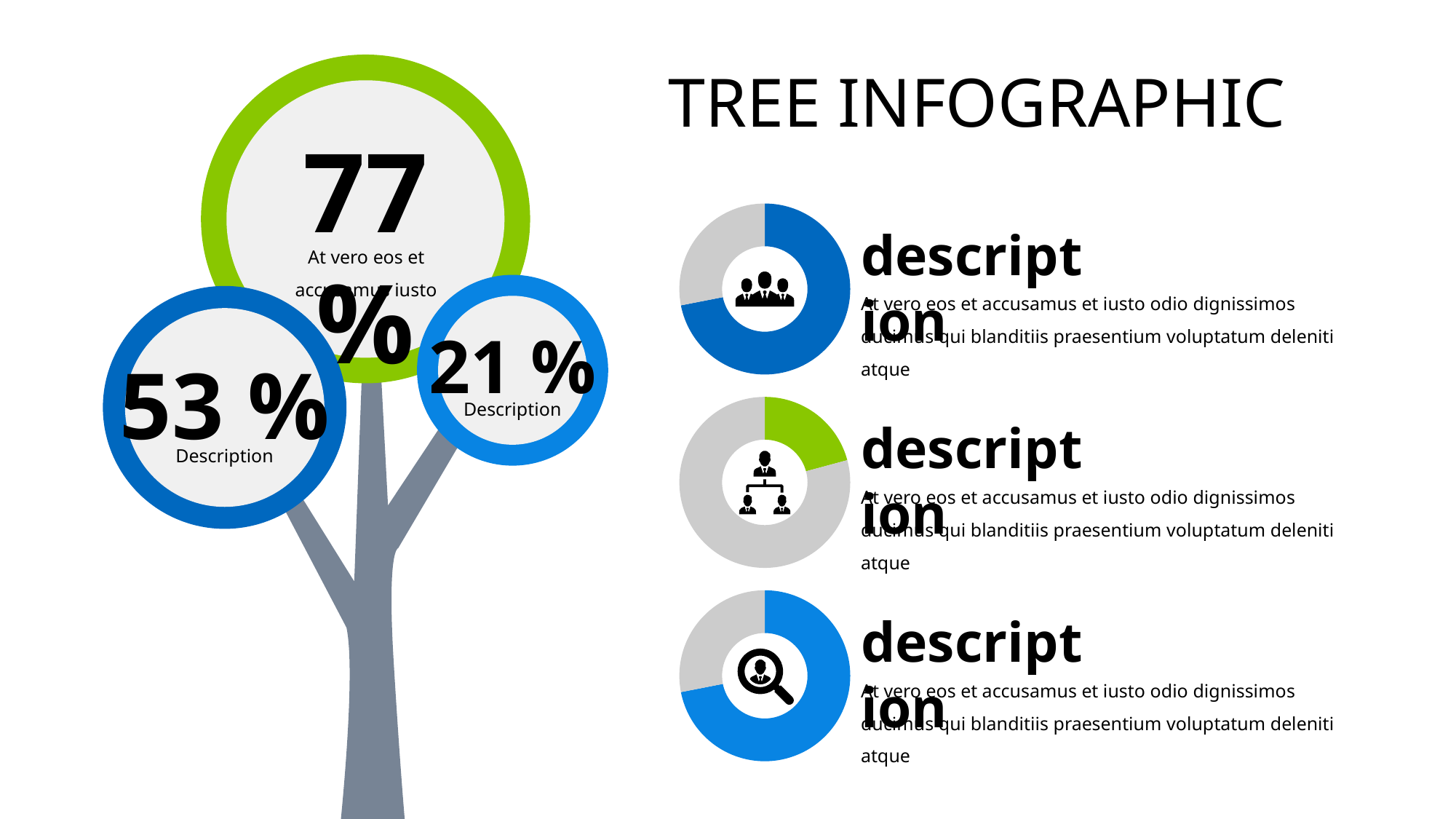
What colour is the filled segment of the top donut chart? Dark blue What kind of chart is shown three times on the right side of the slide? Donut (pie) chart What colour is the filled segment of the middle donut chart? Green How many donut charts are on the slide? 3 Is the coloured segment of the top donut chart larger or smaller than the coloured segment of the middle donut chart? Larger Which of the three donut charts has the smallest coloured segment? The middle one Is the coloured segment of the bottom donut chart larger or smaller than the coloured segment of the middle donut chart? Larger Which of the three donut charts has the largest coloured segment? The top and bottom ones (they are equal)